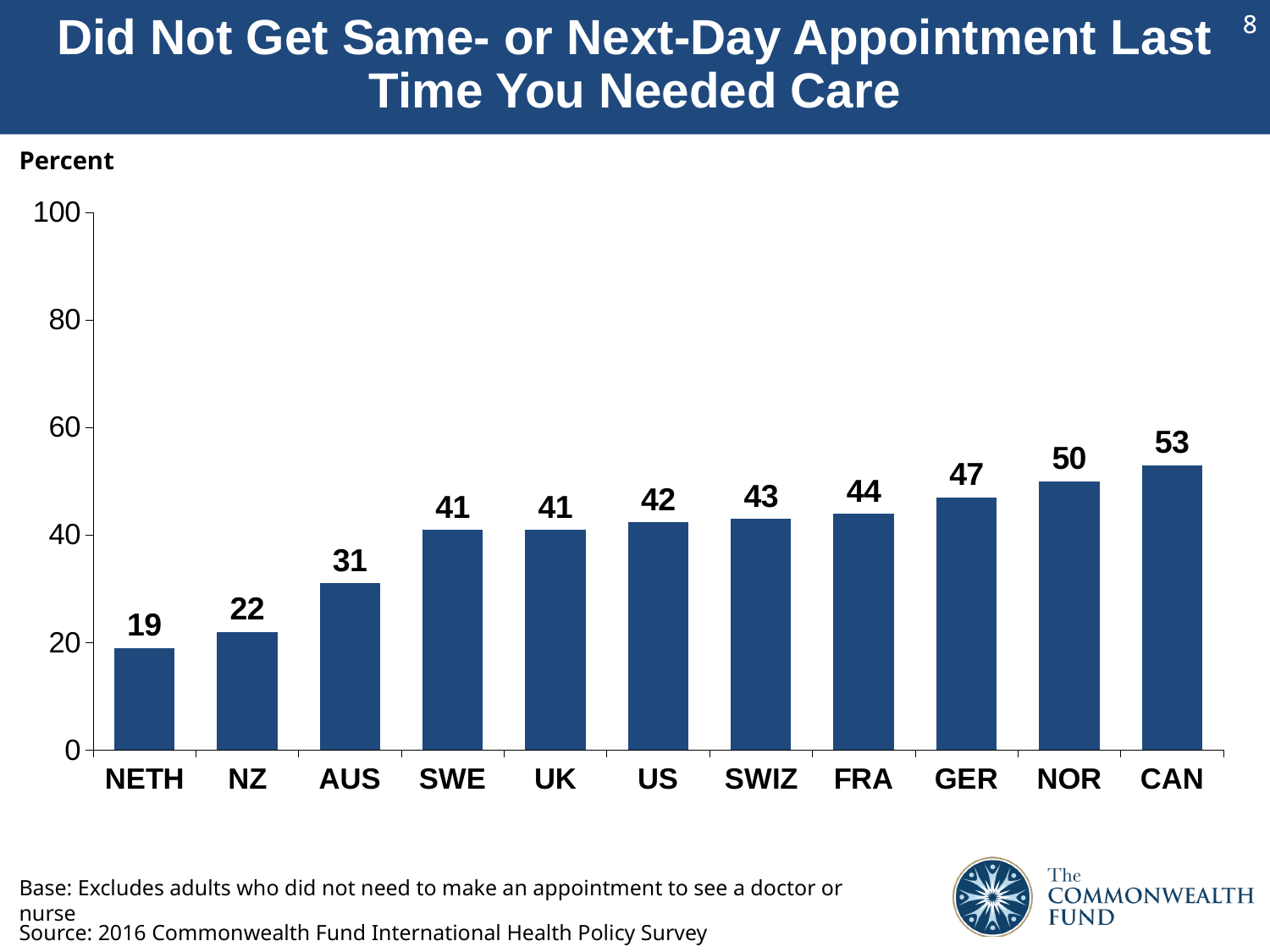
What is the value for NETH? 19 How many countries are shown on the chart? 11 What is the difference between the values for CAN and NETH? 34 What is the value for the US? 42 Is the value for SWIZ greater or less than 40? greater Do the values rise or fall from left to right along the x axis? Rise What is the value for GER? 47 Which has a larger value, FRA or NZ? FRA Which country has the lowest value? NETH What kind of chart is shown on the slide? Bar chart Which country has the highest value? CAN What is the difference between the values for NOR and AUS? 19